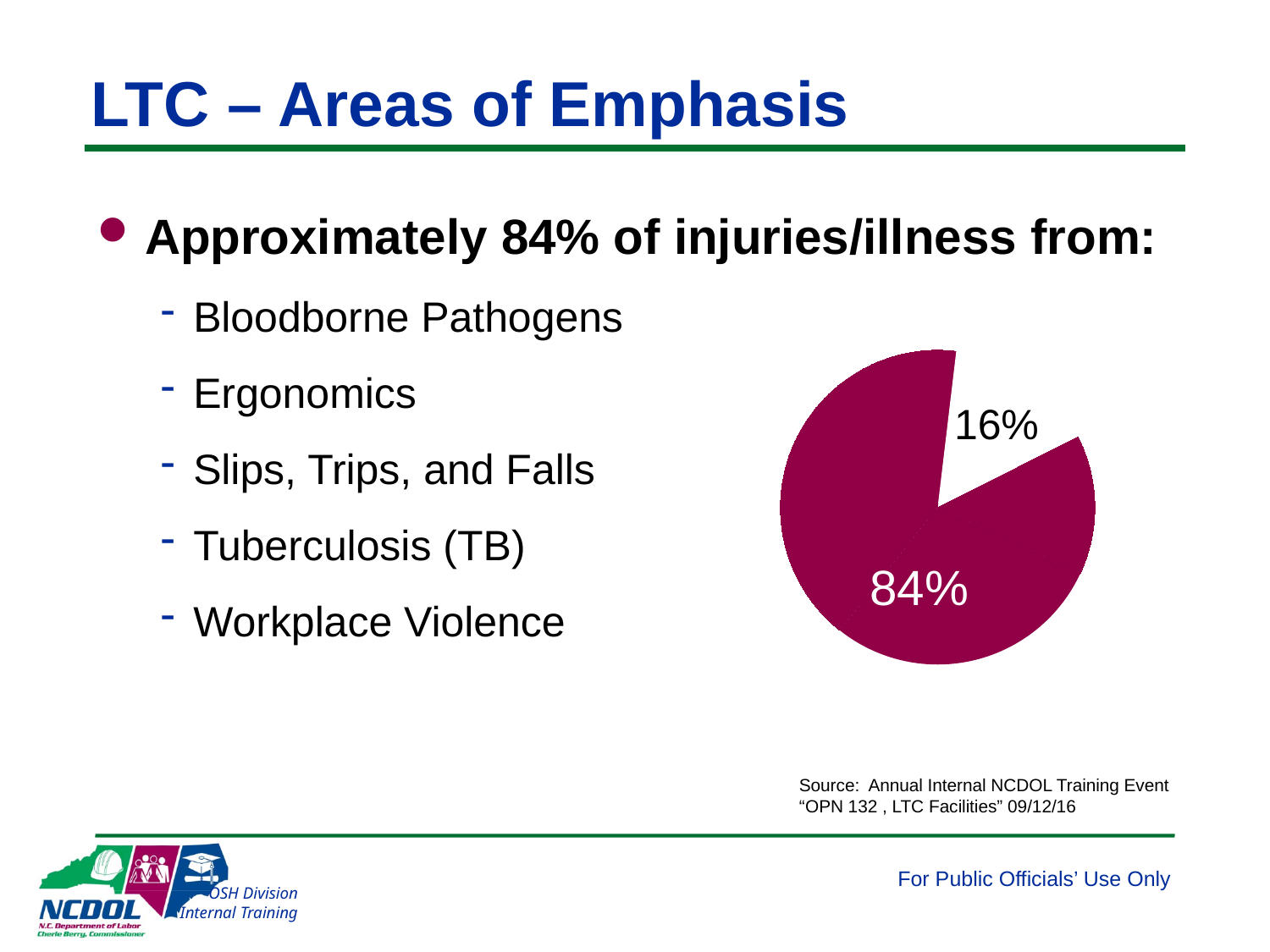
Which slice of the pie chart is separated (exploded) from the rest of the pie? the 16% slice Does the pie chart include a legend? No What is the difference between the two slices of the pie chart, in percentage points? 68 What kind of chart is shown on the slide? pie chart Which slice of the pie chart is larger, the one labelled 84% or the one labelled 16%? 84% What share of the pie does the slice pulled away from the rest of the pie represent? 16% What do the two slices of the pie chart add up to? 100% According to the slide, approximately what percentage of injuries/illness comes from the listed areas of emphasis? 84% What is the value of the largest slice in the pie chart? 84% How many slices does the pie chart have? 2 What is the value of the smallest slice in the pie chart? 16%